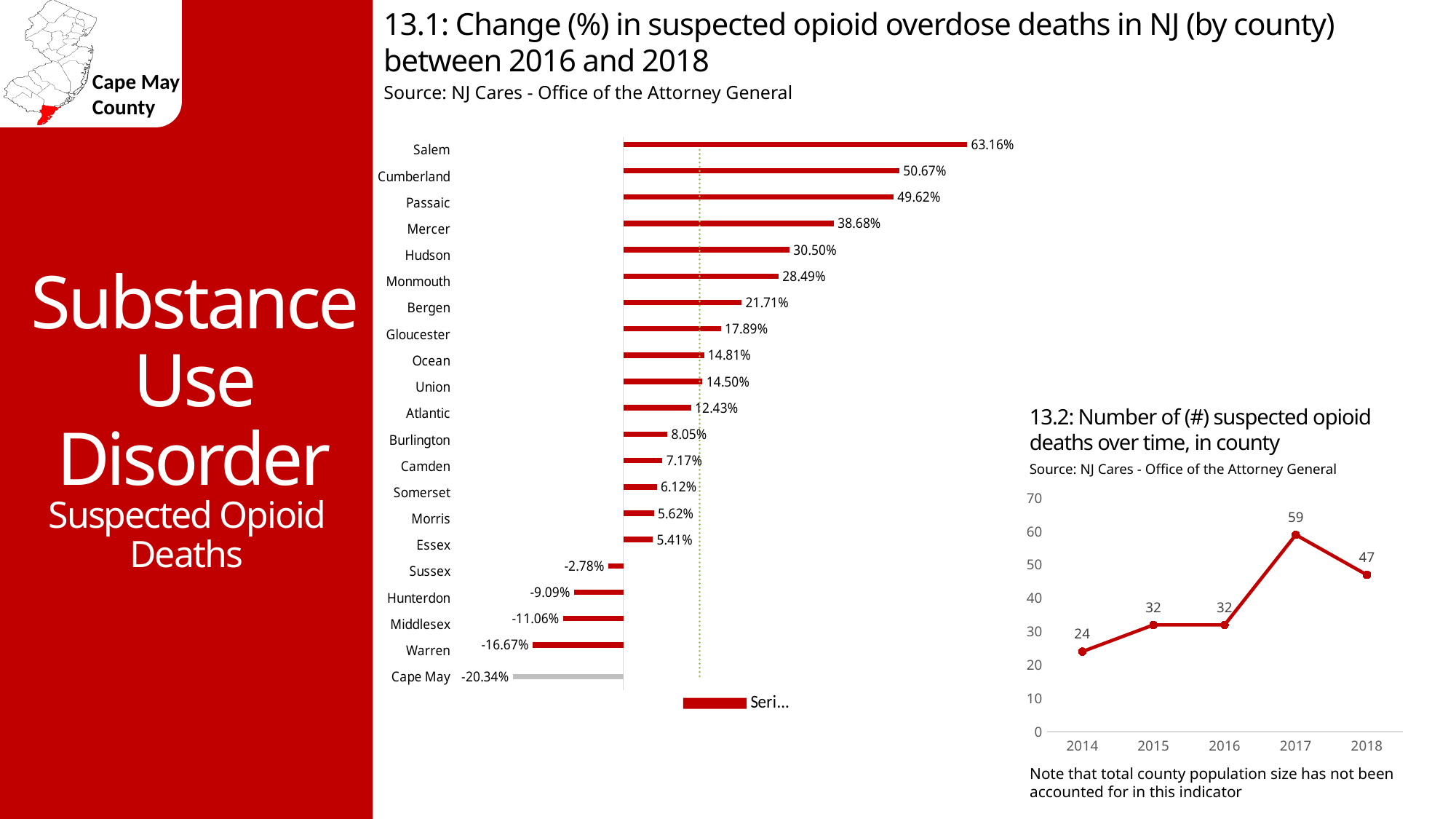
In chart 13.1, what is the difference between the values for Salem and Cumberland? 12.49% In chart 13.1, how many counties are shown? 21 In chart 13.1, which is larger, the value for Hudson or the value for Monmouth? Hudson What kind of chart is chart 13.1? Bar chart In chart 13.1, what is the change (%) in suspected opioid overdose deaths for Cape May? -20.34% In chart 13.1, what is the value for Mercer? 38.68% In chart 13.1, which county has the highest change (%) in suspected opioid overdose deaths? Salem In chart 13.2, which year has the lowest number of suspected opioid deaths? 2014 In chart 13.2, what is the difference between the number of suspected opioid deaths in 2017 and 2018? 12 In chart 13.1, which county has the lowest change (%) in suspected opioid overdose deaths? Cape May What kind of chart is chart 13.2? Line chart In chart 13.2, how many suspected opioid deaths were there in 2017? 59